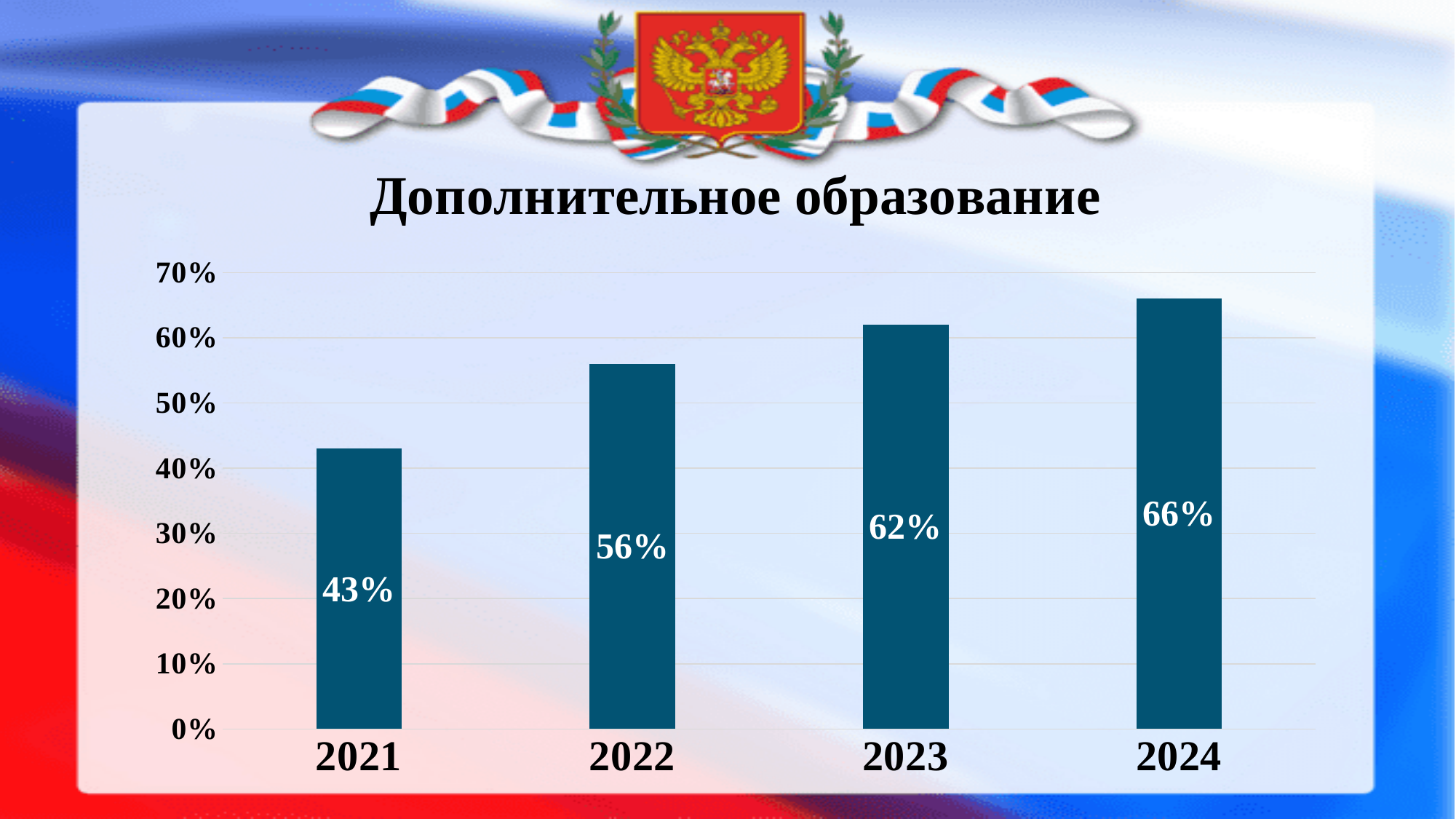
Is the value for 2021 greater or less than 50%? less How many years are shown on the x axis? 4 What is the value for 2024? 66% Which year has the lowest value? 2021 What is the value for 2022? 56% Which is larger, the value for 2022 or the value for 2023? 2023 What is the value for 2023? 62% What kind of chart is shown on the slide? bar chart Which year has the highest value? 2024 What is the difference between the values for 2024 and 2021? 23% What is the value for 2021? 43% What is the difference between the values for 2023 and 2022? 6%